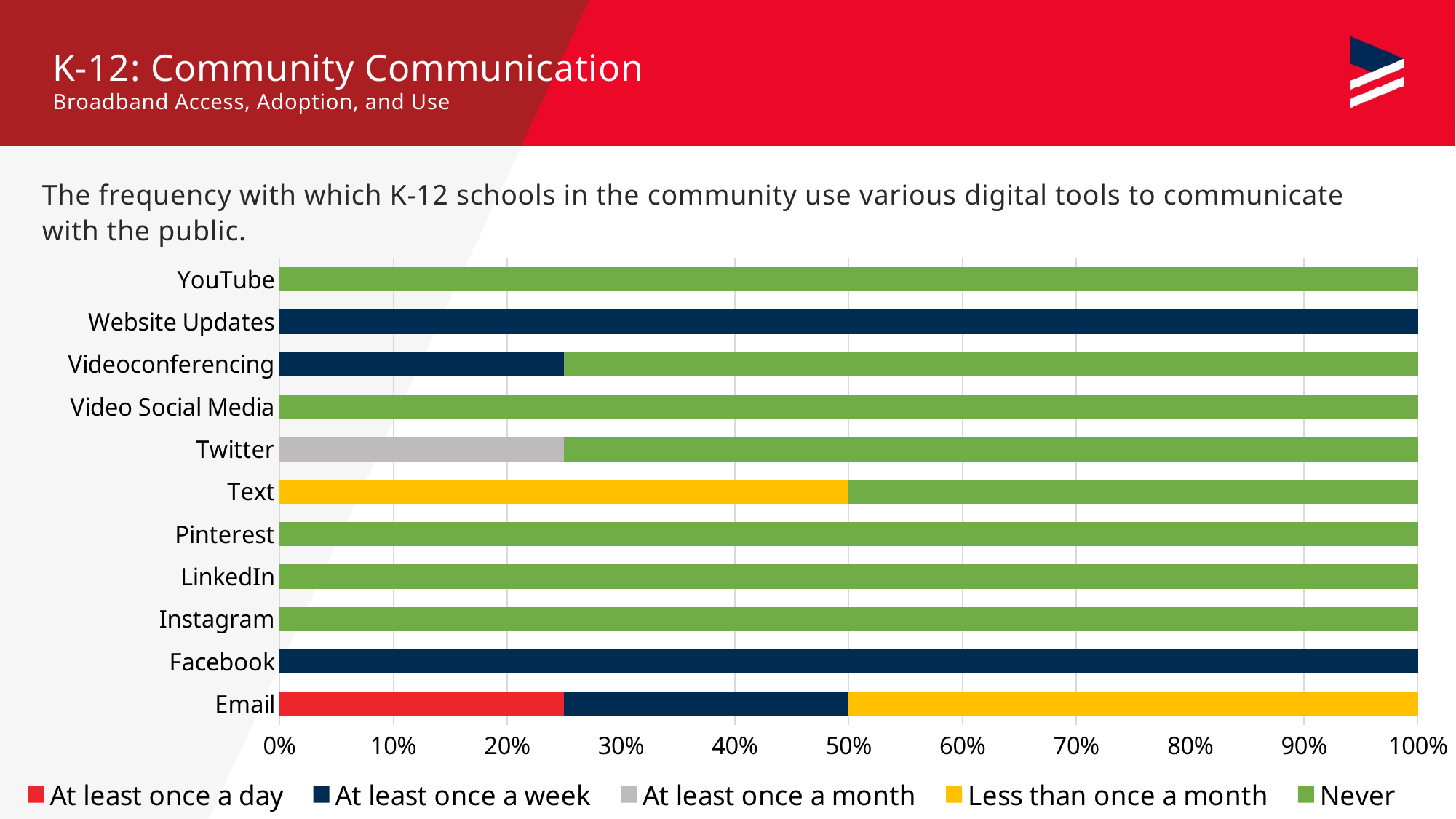
How many digital tools (categories) are listed on the vertical axis of the chart? 11 What kind of chart is shown on the slide? Stacked bar chart What share of K-12 schools report using Text 'Less than once a month'? 50% What share of K-12 schools report using Facebook 'At least once a week'? 100% How many series does the chart's legend list? 5 What share of K-12 schools report 'Never' using YouTube to communicate with the public? 100% Is the 'At least once a week' share for Videoconferencing greater or less than 30%? less Is the 'At least once a month' share for Twitter greater or less than 20%? greater What share of K-12 schools report using Website Updates 'At least once a week'? 100% Which is larger for Email: the 'At least once a day' share or the 'Less than once a month' share? Less than once a month What share of K-12 schools report 'Never' using Text? 50% Which colour represents the 'Never' series in the chart's legend? Green